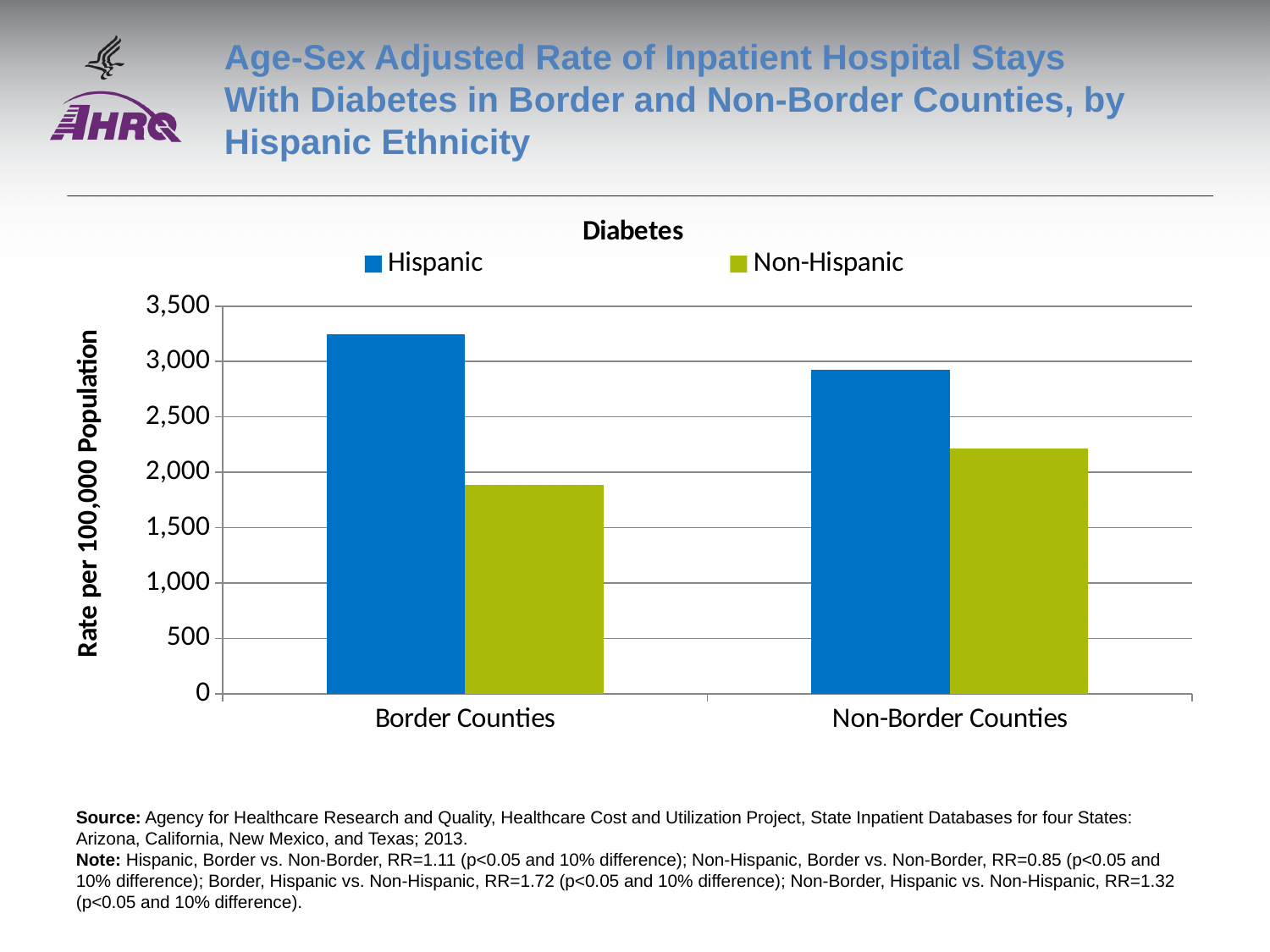
Is the Non-Hispanic value for Non-Border Counties greater or less than 2,000? greater How many series does the legend list? 2 Is the Hispanic value for Border Counties greater or less than 3,000? greater What is the label of the y axis? Rate per 100,000 Population Is the Non-Hispanic value for Border Counties greater or less than 2,000? less In Non-Border Counties, which is larger: the Hispanic or the Non-Hispanic rate? Hispanic For the Non-Hispanic series, which category has the larger value: Border Counties or Non-Border Counties? Non-Border Counties How many categories are shown on the x axis? 2 What kind of chart is shown on the slide? Bar chart Which bar is the highest in the chart? Hispanic, Border Counties Which bar is the lowest in the chart? Non-Hispanic, Border Counties